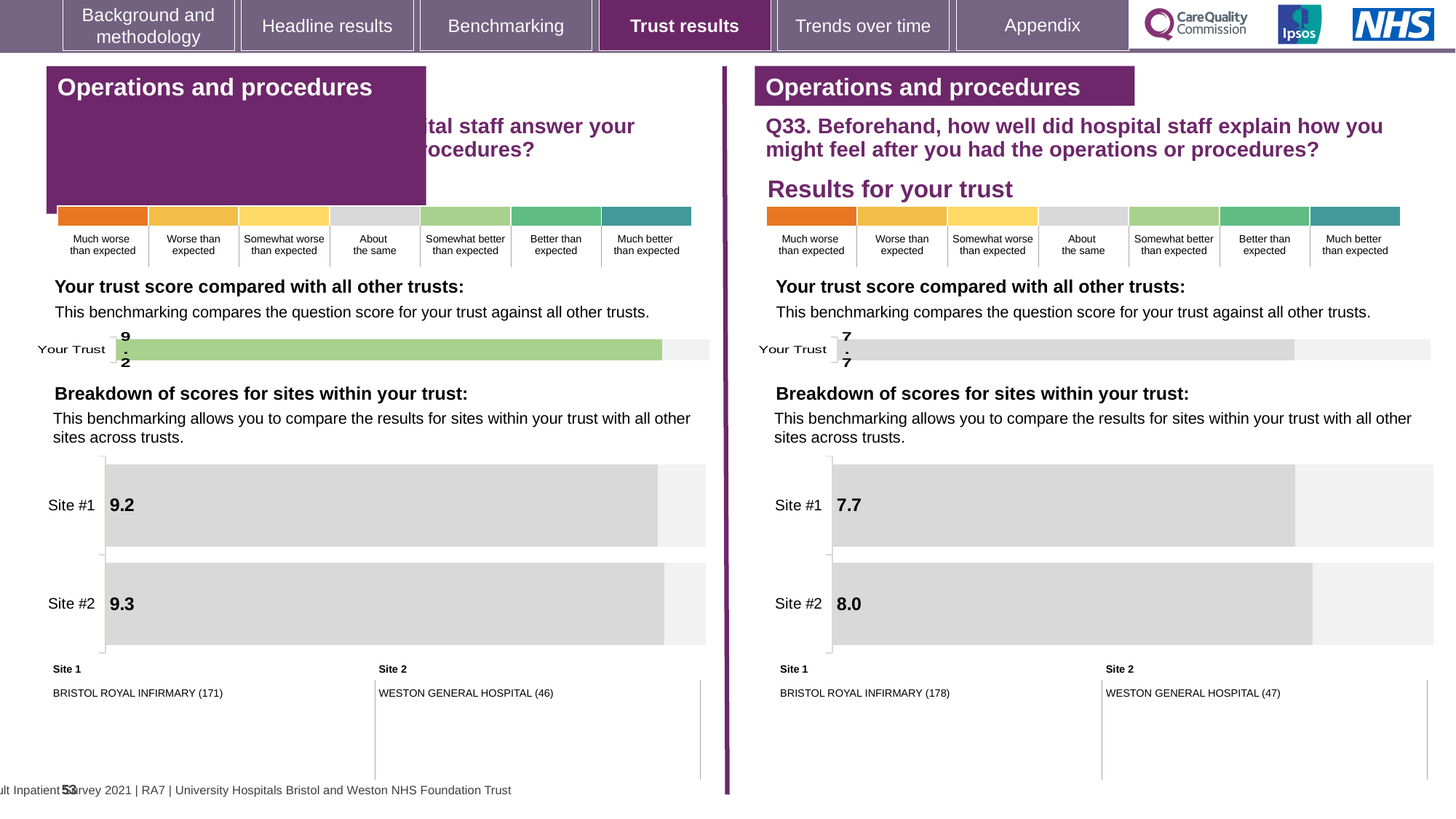
On the right-hand (Q33) site breakdown chart, which site has the higher score? Site #2 What type of chart is used for the site breakdown on the right-hand (Q33) side? Bar chart On the right-hand (Q33) 'Your Trust' chart, what is the score shown for Your Trust? 7.7 On the left-hand site breakdown chart, which site has the lower score? Site #1 On the left-hand site breakdown chart, what is the score for Site #1? 9.2 On the right-hand (Q33) site breakdown chart, what is the score for Site #1? 7.7 Which is larger: the Your Trust score on the left-hand chart or the Your Trust score on the right-hand (Q33) chart? The left-hand chart (9.2) On the left-hand 'Your Trust' chart, what is the score shown for Your Trust? 9.2 On the left-hand site breakdown chart, how many sites are plotted? 2 On the right-hand (Q33) site breakdown chart, what is the score for Site #2? 8.0 On the right-hand (Q33) site breakdown chart, what is the difference between the Site #2 and Site #1 scores? 0.3 On the left-hand site breakdown chart, what is the score for Site #2? 9.3